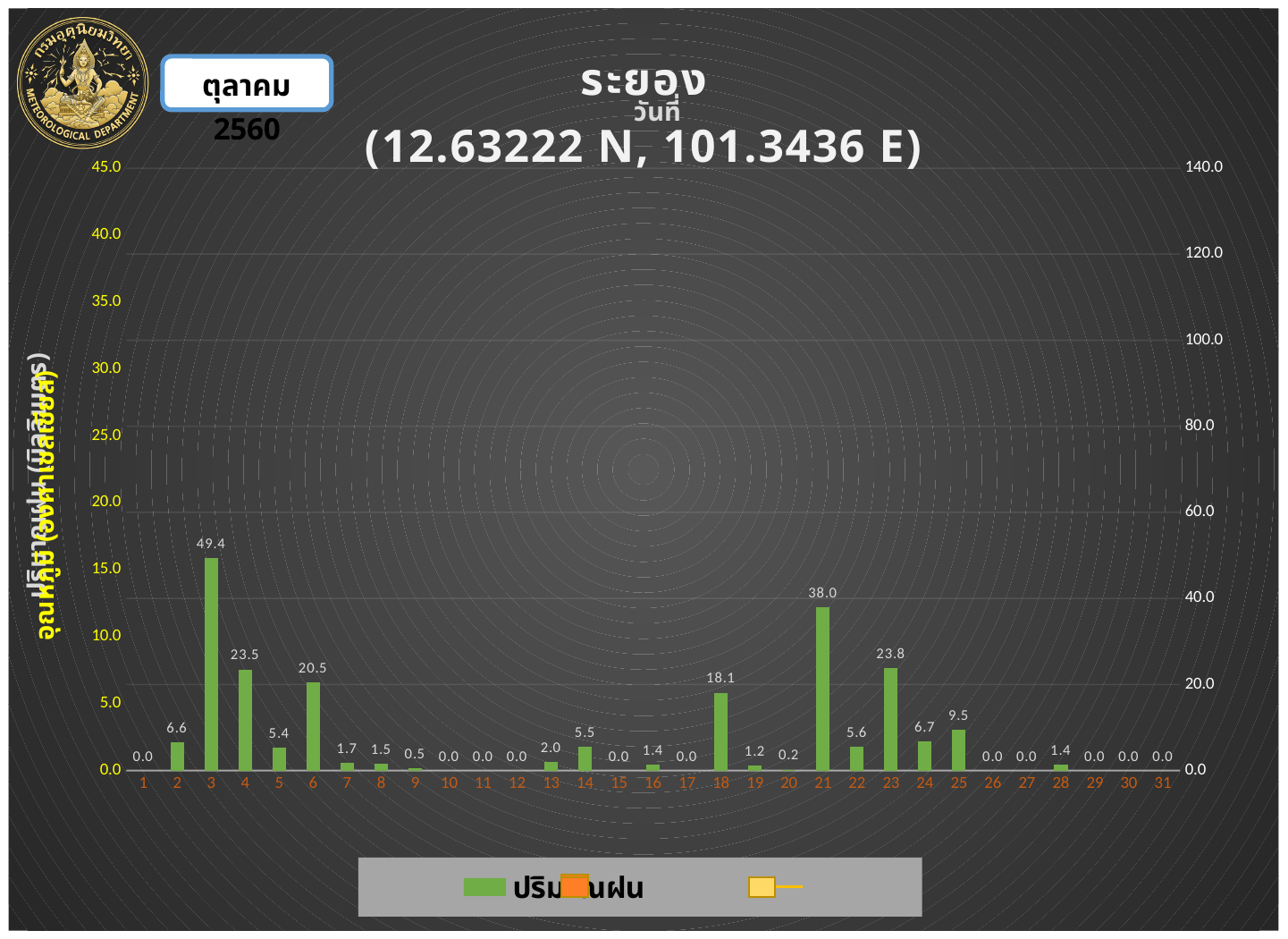
What is the difference between the rainfall values for day 3 and day 21? 11.4 Which has the larger rainfall value, day 23 or day 4? day 23 What is the rainfall value shown for day 18? 18.1 What is the station name shown in the chart title? ระยอง What is the rainfall value shown for day 21? 38.0 Which has the larger rainfall value, day 6 or day 18? day 6 What kind of chart is shown on the slide? bar chart Which day has the highest rainfall value? 3 How many days are shown on the x axis? 31 What is the rainfall value shown for day 3? 49.4 What is the rainfall value shown for day 25? 9.5 Is the value for day 21 greater or less than 20.0 on the right axis? greater